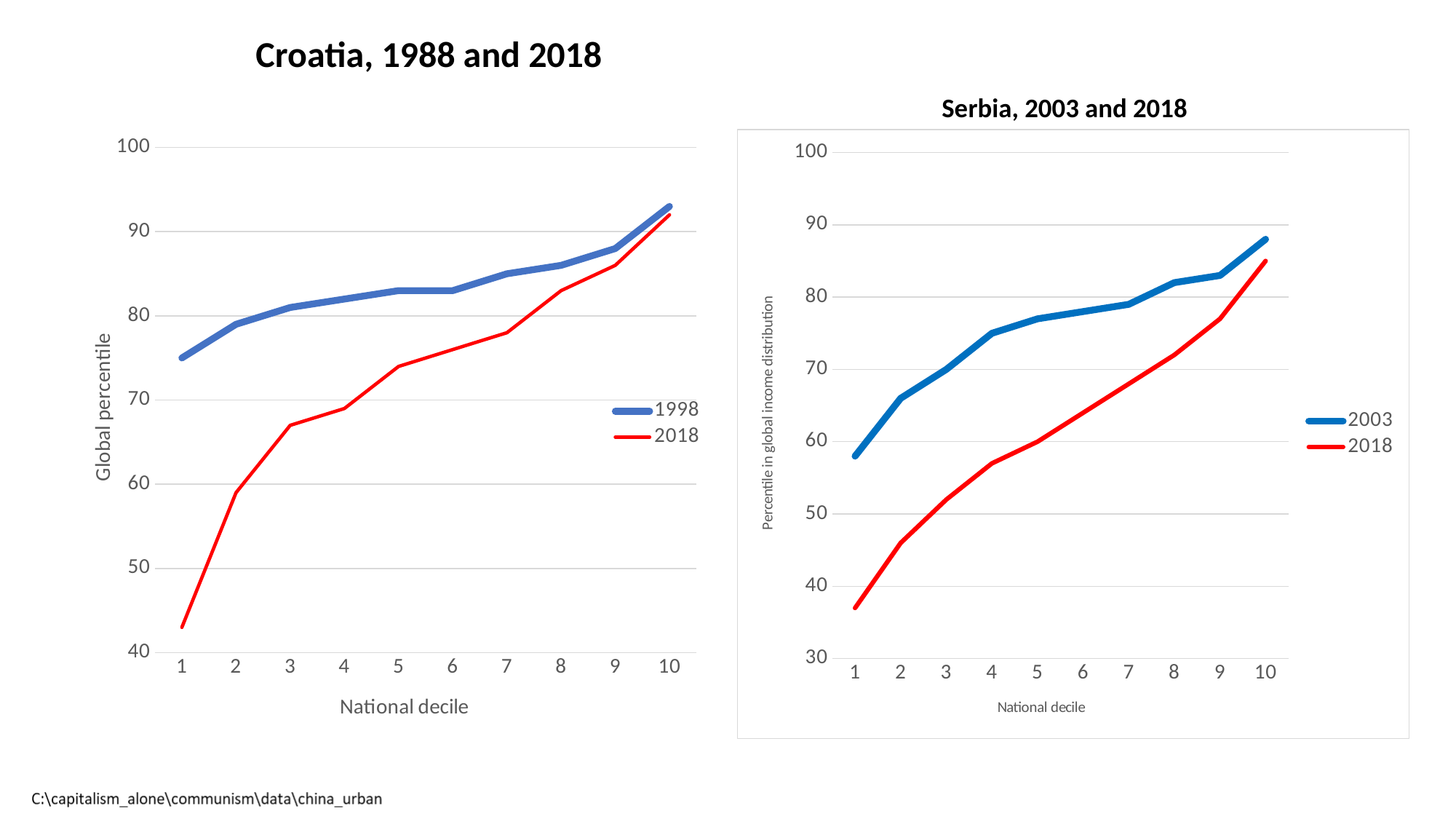
In the Croatia, 1988 and 2018 chart, which series has the larger value at decile 5, 1998 or 2018? 1998 In the Serbia, 2003 and 2018 chart, do the values of the 2018 series rise or fall as the national decile increases? rise In the Serbia, 2003 and 2018 chart, is the 2003 value for decile 10 greater or less than 80? greater In the Serbia, 2003 and 2018 chart, which series has the larger value at decile 5, 2003 or 2018? 2003 How many national deciles are plotted on the x axis of the Croatia, 1988 and 2018 chart? 10 In the Croatia, 1988 and 2018 chart, is the 1998 value for decile 1 greater or less than 70? greater What is the y-axis label of the Serbia, 2003 and 2018 chart? Percentile in global income distribution How many series does the legend of the Serbia, 2003 and 2018 chart list? 2 In the Serbia, 2003 and 2018 chart, at which national decile is the 2018 series lowest? 1 In the Serbia, 2003 and 2018 chart, is the 2018 value for decile 1 greater or less than 40? less What kind of chart is the Croatia, 1988 and 2018 chart? line chart